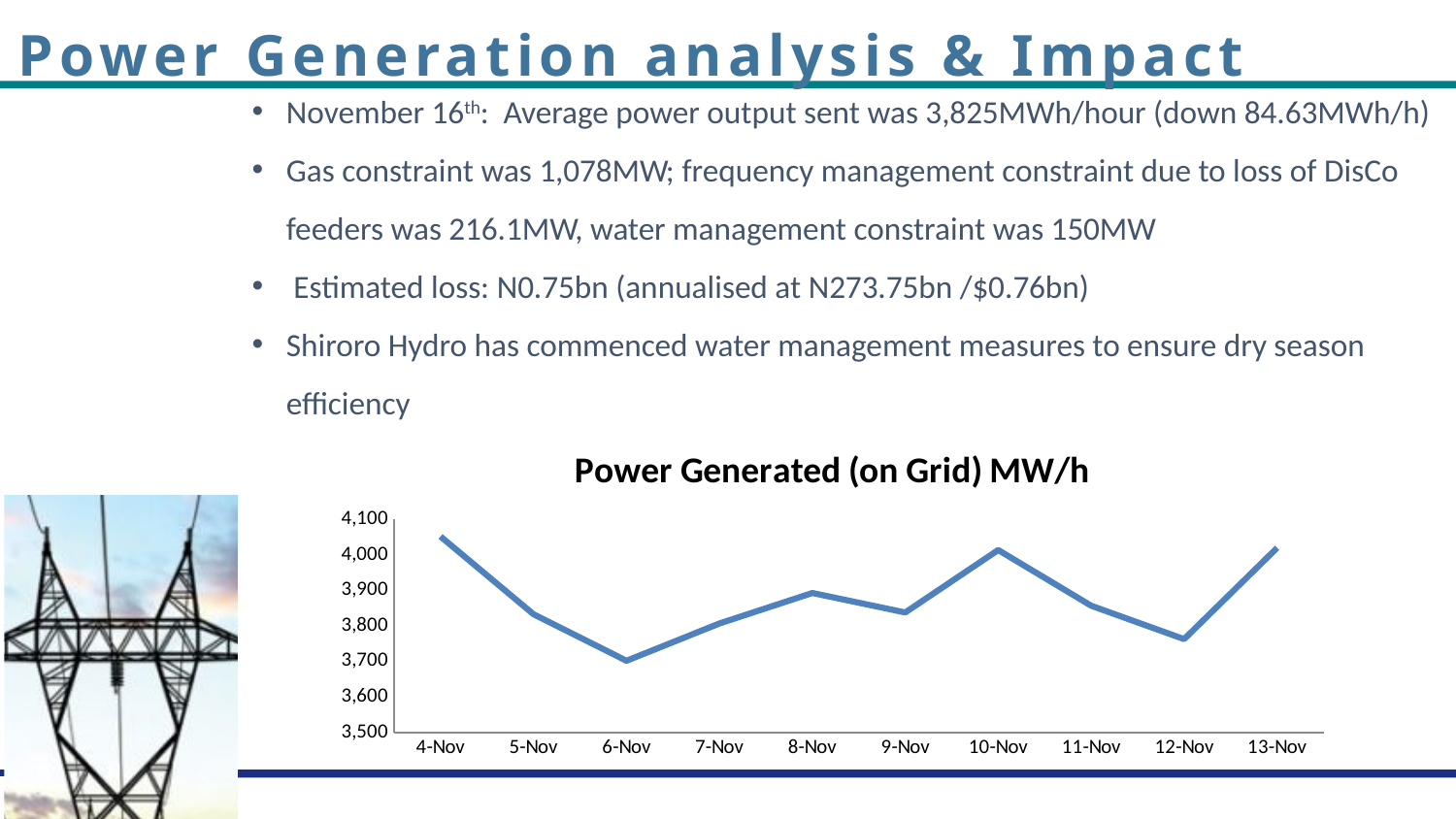
Is the value for 12-Nov greater or less than 3,800? less Does the power generated rise or fall from 4-Nov to 6-Nov? fall Is the value for 6-Nov greater or less than 3,800? less Is the value for 10-Nov greater or less than 3,900? greater Which date has the larger value, 8-Nov or 12-Nov? 8-Nov On which date is the power generated lowest? 6-Nov On which date is the power generated highest? 4-Nov What kind of chart is shown on the slide? line chart How many dates are plotted on the x axis of the chart? 10 Which date has the larger value, 10-Nov or 11-Nov? 10-Nov What is the title of the chart? Power Generated (on Grid) MW/h